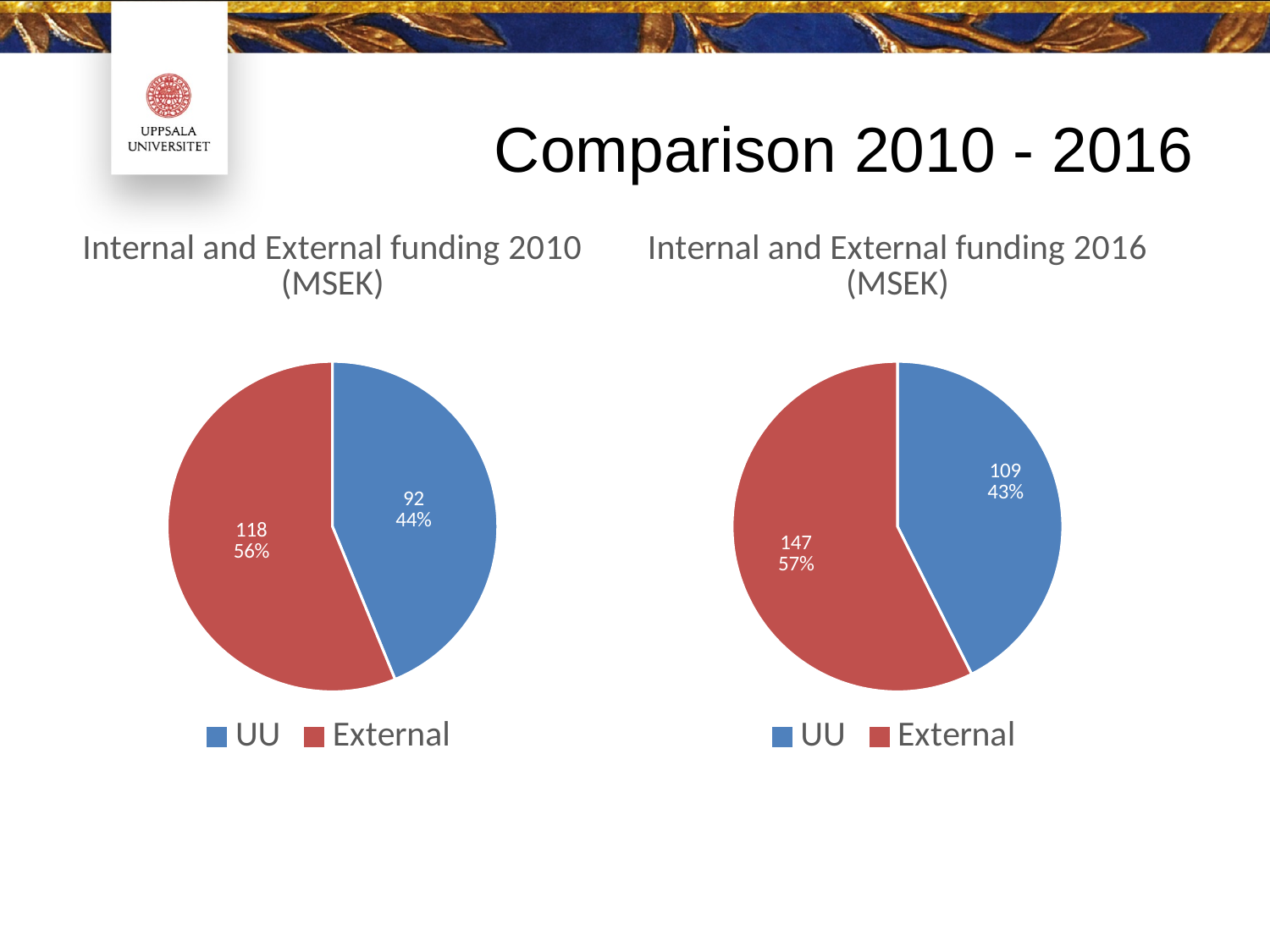
In the 'Internal and External funding 2016 (MSEK)' chart, which category has the smallest slice? UU In the 'Internal and External funding 2010 (MSEK)' chart, what is the difference between the External and UU values? 26 How many categories does the legend of the 'Internal and External funding 2010 (MSEK)' chart list? 2 In the 'Internal and External funding 2010 (MSEK)' chart, what is the value for External? 118 What kind of chart is the 'Internal and External funding 2016 (MSEK)' chart? Pie chart In the 'Internal and External funding 2016 (MSEK)' chart, what is the value for External? 147 In the 'Internal and External funding 2010 (MSEK)' chart, which category has the largest slice? External In the 'Internal and External funding 2010 (MSEK)' chart, what share of the pie does External represent? 56% In the 'Internal and External funding 2016 (MSEK)' chart, what share of the pie does UU represent? 43% In the 'Internal and External funding 2010 (MSEK)' chart, what is the value for UU? 92 In the 'Internal and External funding 2016 (MSEK)' chart, what is the value for UU? 109 In the 'Internal and External funding 2016 (MSEK)' chart, what is the difference between the External and UU values? 38